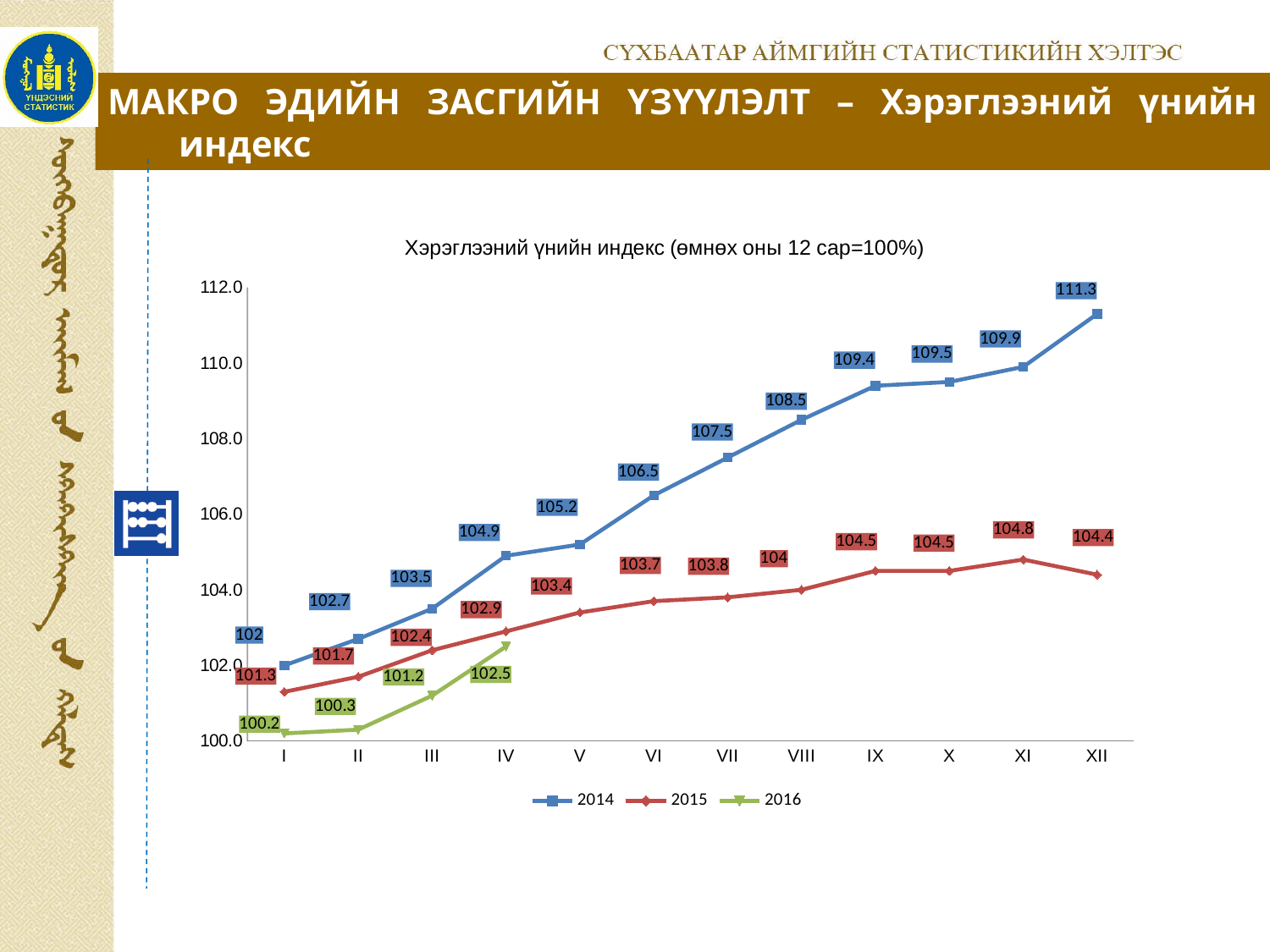
How many months are plotted for the 2016 series? 4 Does the 2014 series rise or fall from month I to month XII? rise What is the value for 2016 in month IV? 102.5 What type of chart is shown on the slide? line chart What is the title of the chart? Хэрэглээний үнийн индекс (өмнөх оны 12 сар=100%) What is the value for 2014 in month XII? 111.3 In which month is the 2014 series lowest? I How many series does the legend list? 3 Which series has the larger value in month III, 2014 or 2016? 2014 What is the difference between the 2014 and 2015 values in month XII? 6.9 What is the value for 2015 in month VIII? 104 In which month does the 2015 series reach its highest value? XI